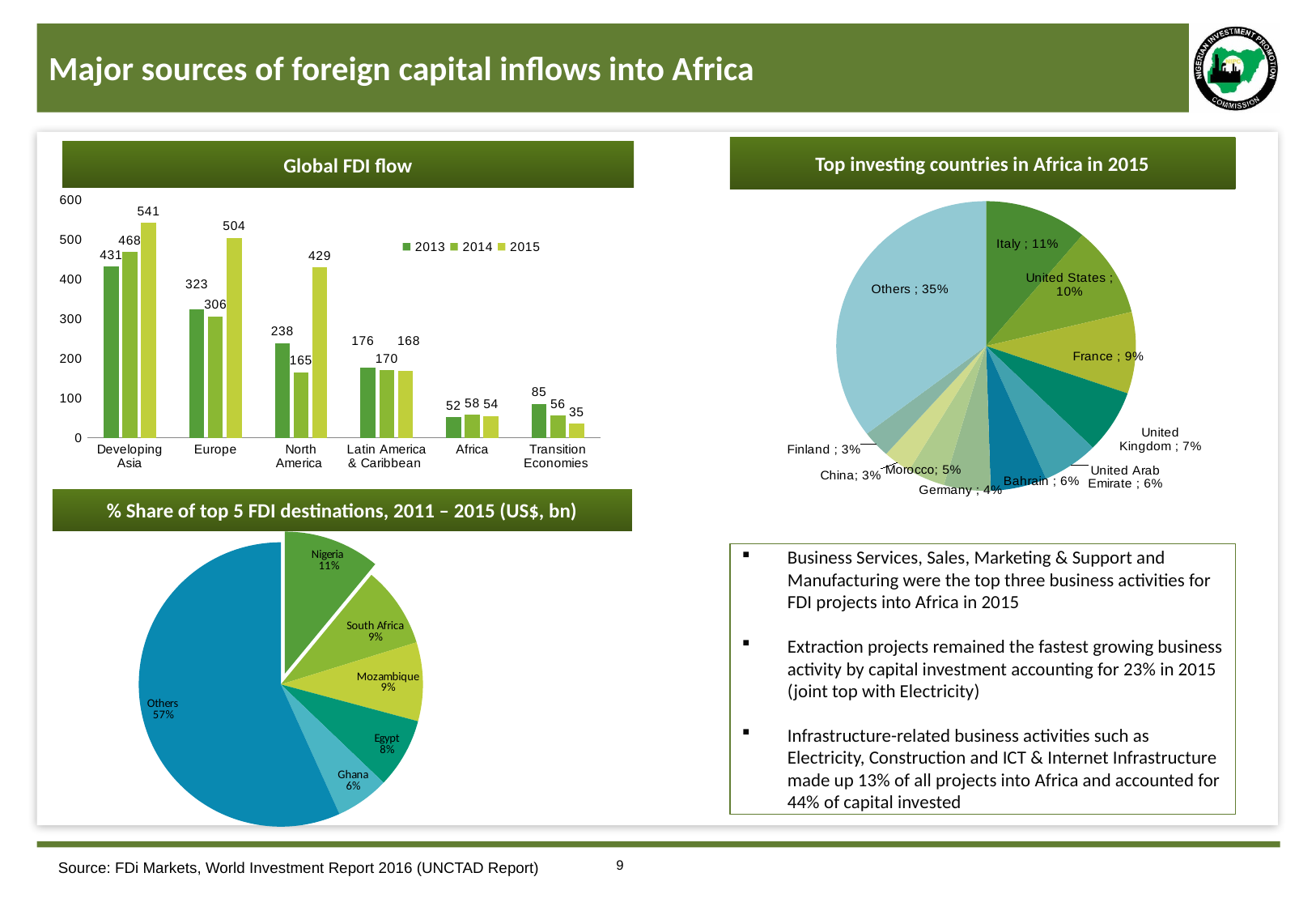
What kind of chart is the Global FDI flow chart? bar chart In the Global FDI flow chart, how many series does the legend list? 3 In the Top investing countries in Africa in 2015 chart, what share does France have? 9% In the Global FDI flow chart, do the values for Transition Economies rise or fall from 2013 to 2015? fall In the Global FDI flow chart, what is the value for Developing Asia in 2015? 541 In the % Share of top 5 FDI destinations chart, what share does Nigeria have? 11% In the Global FDI flow chart, what is the difference between the 2015 and 2014 values for North America? 264 In the Global FDI flow chart, what is the value for Europe in 2014? 306 In the Global FDI flow chart, which region has the lowest value in 2013? Africa In the Global FDI flow chart, which region has the highest value in 2015? Developing Asia In the Top investing countries in Africa in 2015 chart, which is larger, the share for Italy or the share for United Kingdom? Italy In the % Share of top 5 FDI destinations chart, which of the named countries has the smallest share? Ghana